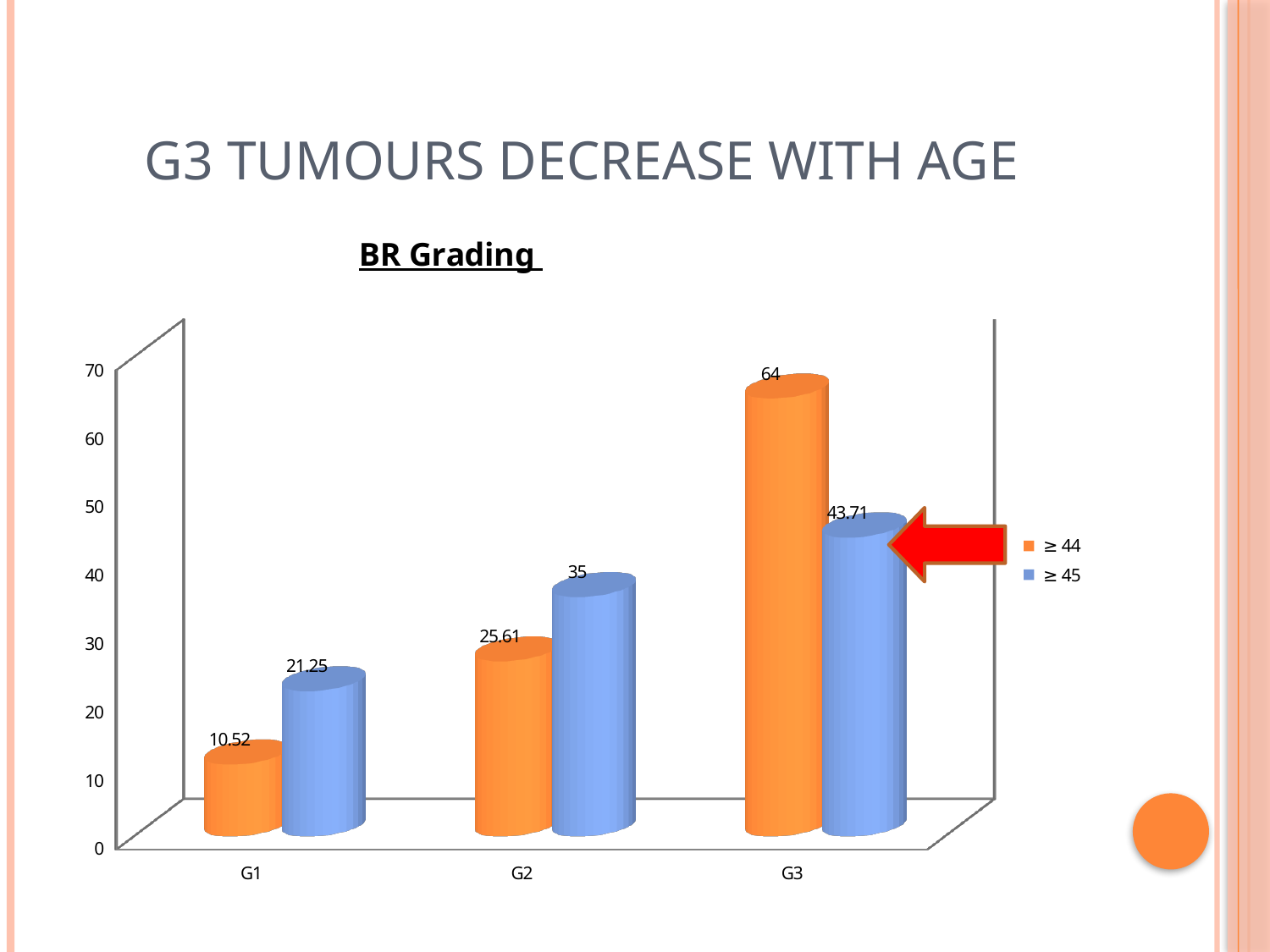
What is the value for G2 in the ≥ 44 series? 25.61 What is the title of the chart? BR Grading What is the value for G1 in the ≥ 45 series? 21.25 Which grade has the highest value in the ≥ 44 series? G3 For G2, which series has the larger value, ≥ 44 or ≥ 45? ≥ 45 What is the difference between the ≥ 44 and ≥ 45 values for G3? 20.29 How many grade categories are shown on the x axis? 3 What is the value for G3 in the ≥ 45 series? 43.71 Which grade has the lowest value in the ≥ 45 series? G1 How many series does the legend list? 2 What kind of chart is shown on the slide? Bar chart What is the value for G3 in the ≥ 44 series? 64